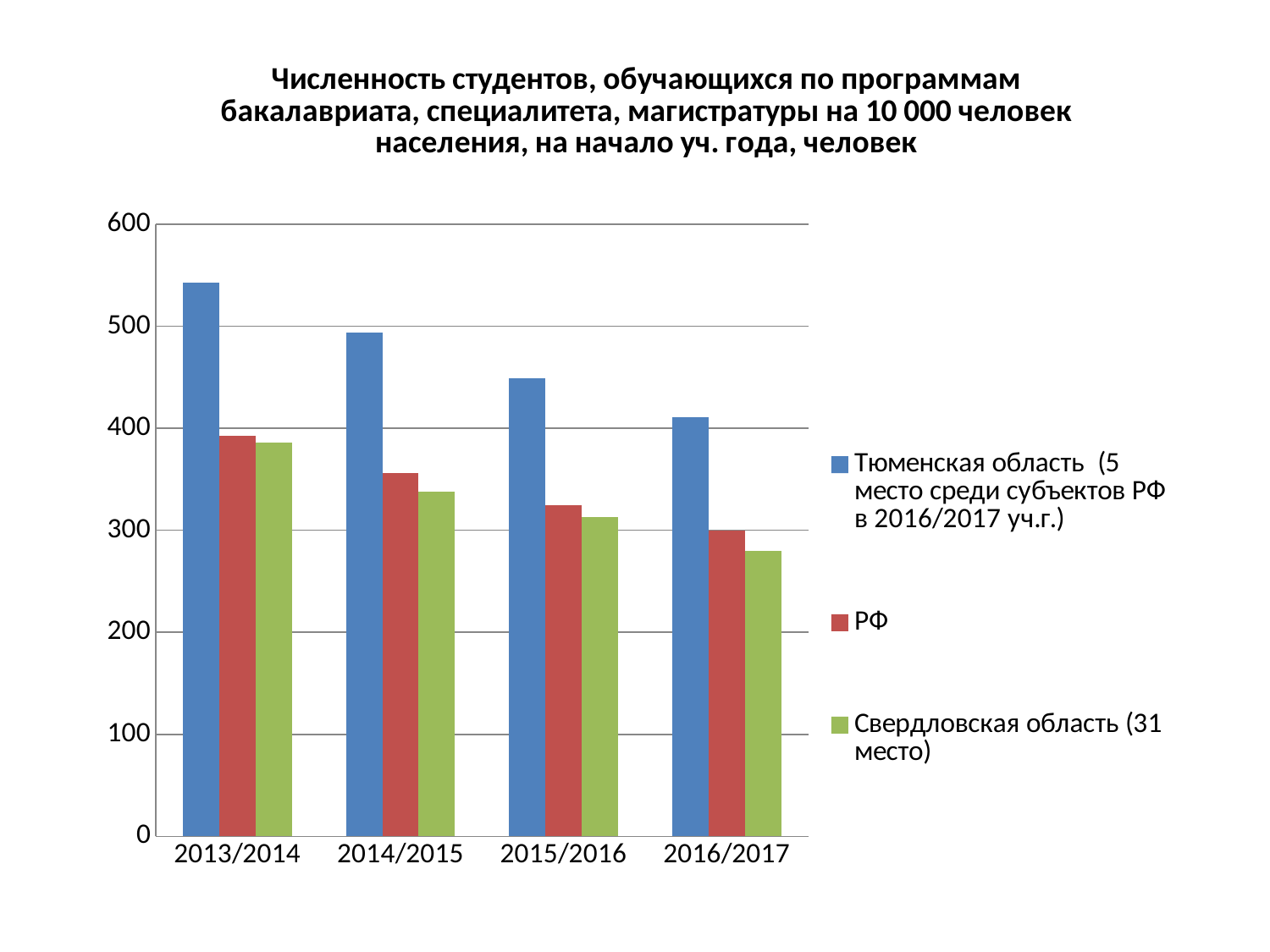
What kind of chart is shown on the slide? bar chart Is the value for Свердловская область in 2014/2015 greater or less than 300? greater In which year is the value for Тюменская область the lowest? 2016/2017 Is the value for Тюменская область in 2015/2016 greater or less than 500? less Is the value for Свердловская область in 2016/2017 greater or less than 300? less How many series does the legend list? 3 How many academic years are shown on the x axis? 4 Which series has the highest value in every year shown? Тюменская область Do the values for Тюменская область rise or fall from 2013/2014 to 2016/2017? fall In 2016/2017, which is larger: the value for РФ or the value for Свердловская область? РФ Which colour represents РФ in the chart? red